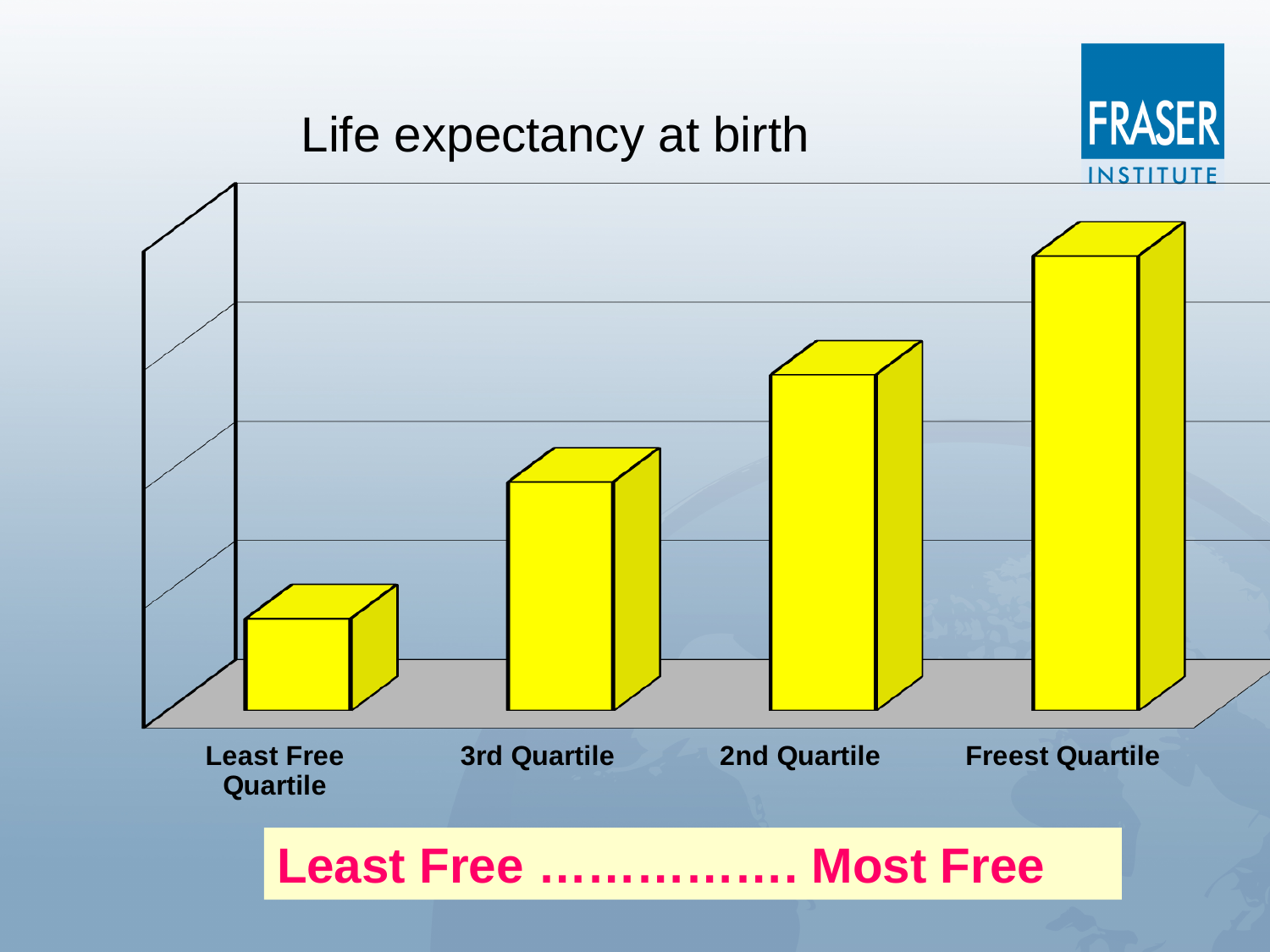
Which category has the highest life expectancy at birth? Freest Quartile How many categories are plotted in the chart? 4 What kind of chart is shown on the slide? Bar chart Which category is plotted second from the left on the x axis? 3rd Quartile Which has a lower value, Least Free Quartile or Freest Quartile? Least Free Quartile What colour are the bars in the chart? Yellow Do the values rise or fall moving from Least Free Quartile to Freest Quartile along the x axis? Rise Which has a higher value, 3rd Quartile or 2nd Quartile? 2nd Quartile What is the title of the chart? Life expectancy at birth Which category has the lowest life expectancy at birth? Least Free Quartile